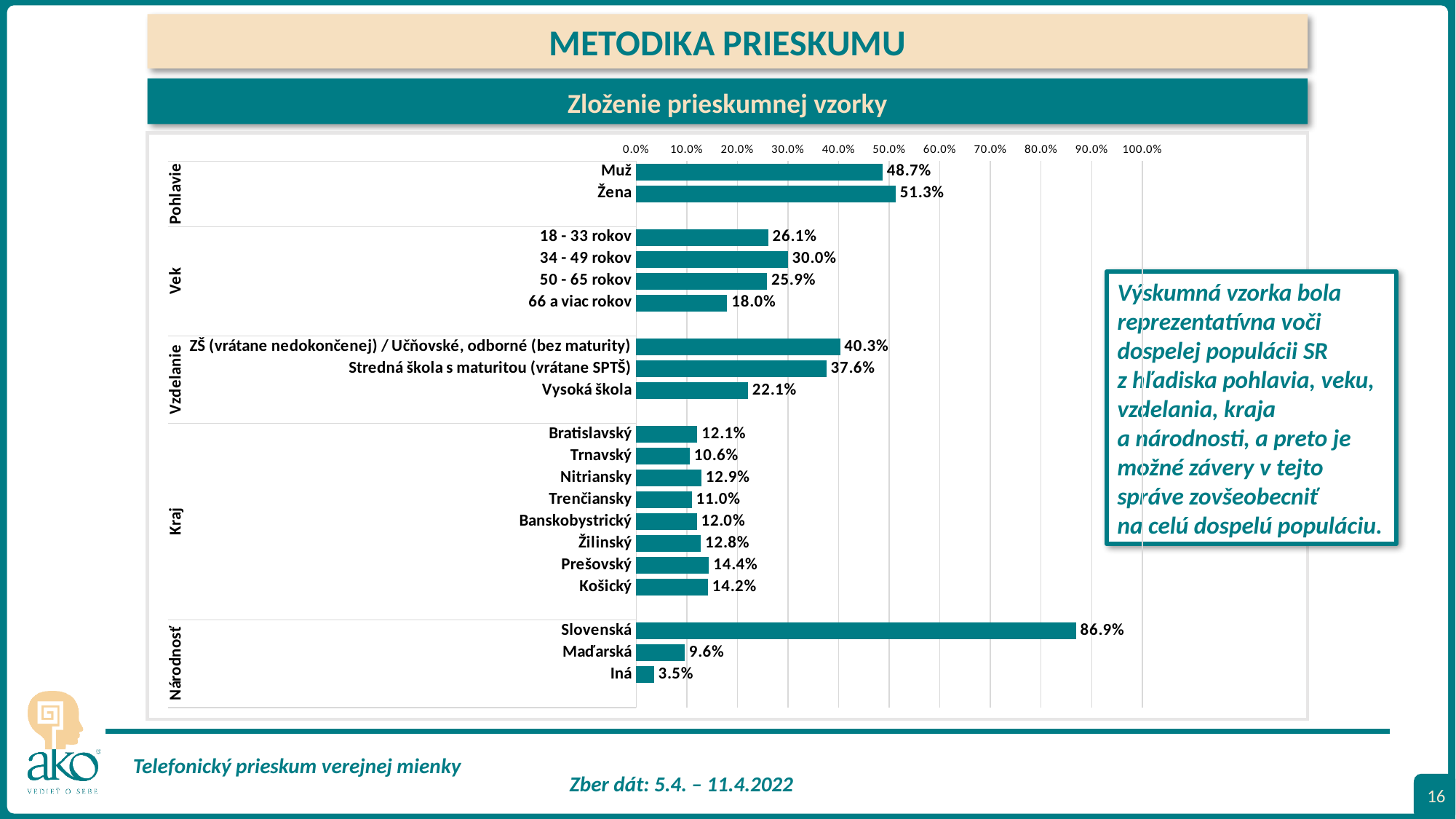
Which category has the highest value in the chart? Slovenská What is the value for Žena? 51.3% What is the value for 66 a viac rokov? 18.0% Which category has the lowest value in the chart? Iná What is the difference between the values for Žena and Muž? 2.6% What type of chart is shown on the slide? Bar chart Which is larger, the value for 34 - 49 rokov or 50 - 65 rokov? 34 - 49 rokov What is the value for Prešovský? 14.4% What is the value for Vysoká škola? 22.1% Which of the Kraj categories has the lowest value? Trnavský How many Kraj categories are shown in the chart? 8 What is the difference between the values for Slovenská and Maďarská? 77.3%